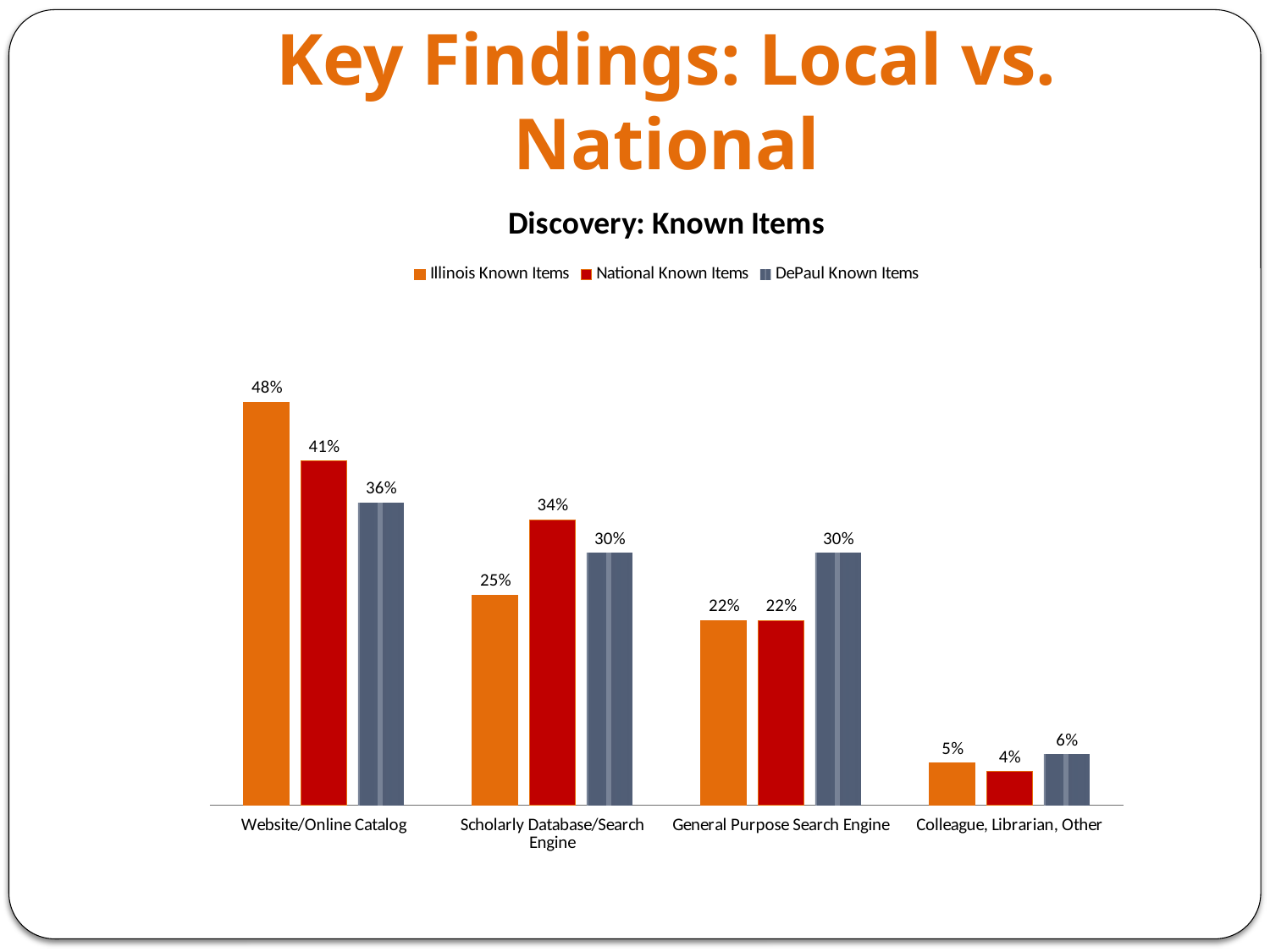
What is the value for National Known Items in the Scholarly Database/Search Engine category? 34% What is the value for DePaul Known Items in the General Purpose Search Engine category? 30% Which category has the highest value for Illinois Known Items? Website/Online Catalog What is the title of the chart? Discovery: Known Items How many series does the legend list? 3 What is the difference between the Illinois Known Items and National Known Items values in the Website/Online Catalog category? 7% What kind of chart is shown on the slide? Bar chart Which series is shown in red in the legend? National Known Items What is the value for Illinois Known Items in the Website/Online Catalog category? 48% How many categories are shown on the x axis? 4 Which category has the lowest value for National Known Items? Colleague, Librarian, Other Which is larger in the Scholarly Database/Search Engine category: Illinois Known Items or DePaul Known Items? DePaul Known Items